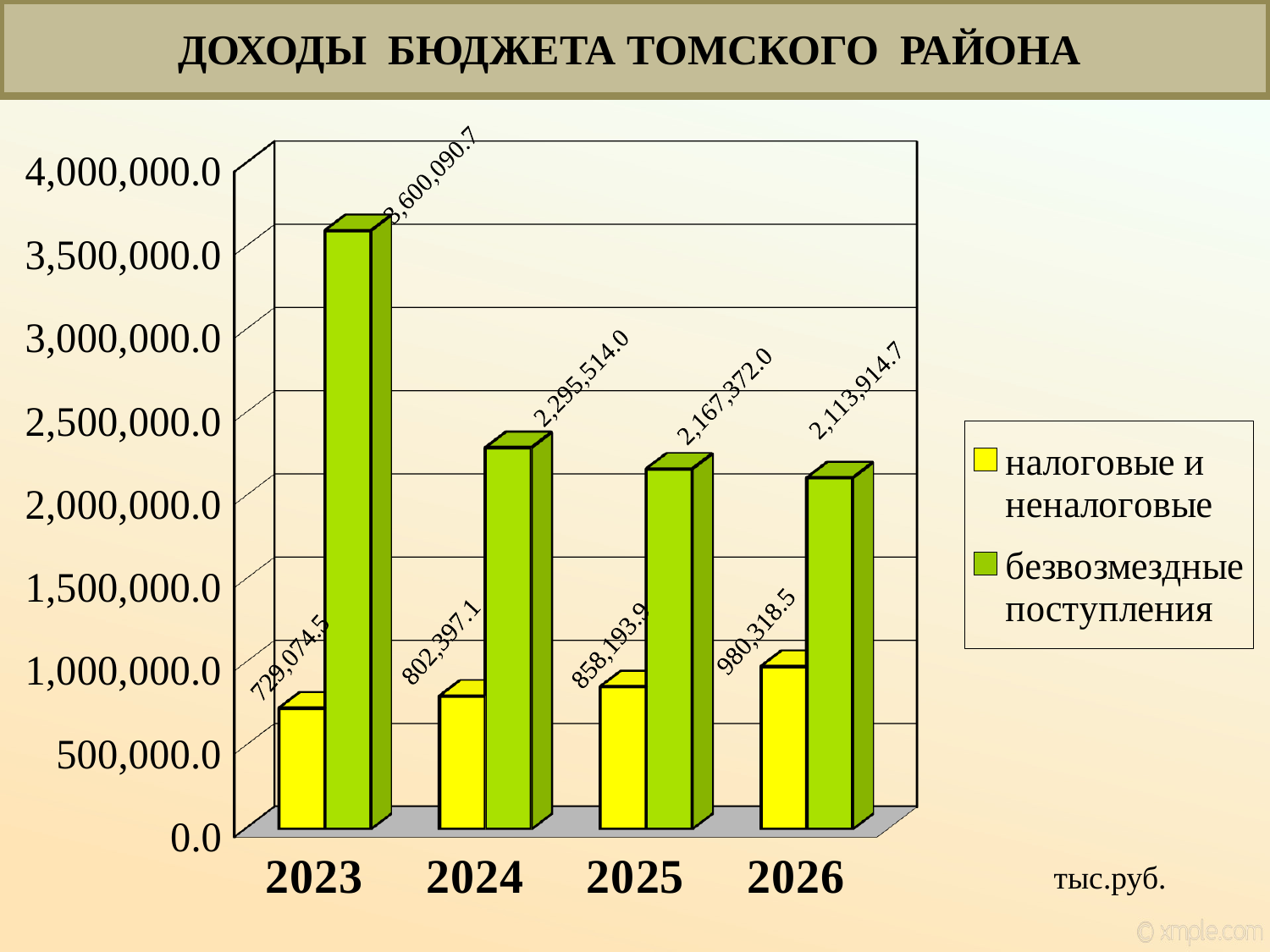
What is the value for безвозмездные поступления in 2025? 2,167,372.0 By how much does безвозмездные поступления in 2024 exceed that in 2025? 128,142.0 What is the difference between безвозмездные поступления and налоговые и неналоговые in 2023? 2,871,016.2 In which year is безвозмездные поступления highest? 2023 What is the value for безвозмездные поступления in 2024? 2,295,514.0 Do the values for налоговые и неналоговые rise or fall from 2023 to 2026? rise Which is larger in 2026: налоговые и неналоговые or безвозмездные поступления? безвозмездные поступления How many series does the legend list? 2 What is the value for налоговые и неналоговые in 2026? 980,318.5 How many years are shown on the x axis? 4 What is the value for налоговые и неналоговые in 2023? 729,074.5 In which year is налоговые и неналоговые lowest? 2023